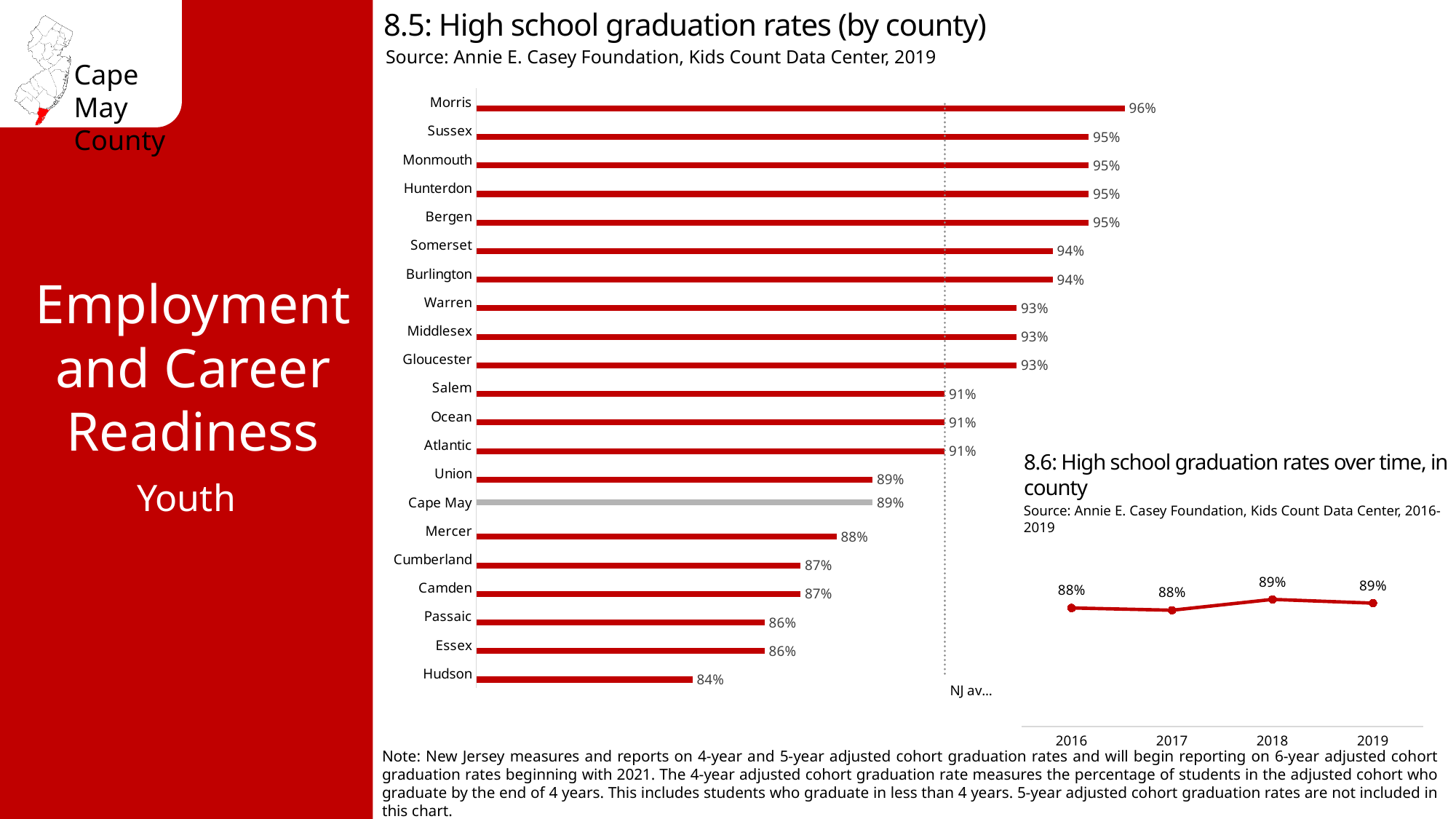
How many counties are shown in the chart '8.5: High school graduation rates (by county)'? 21 In the chart '8.5: High school graduation rates (by county)', which has a higher graduation rate, Somerset or Passaic? Somerset In the chart '8.5: High school graduation rates (by county)', which county has the highest graduation rate? Morris In the chart '8.5: High school graduation rates (by county)', what is the difference between the graduation rates of Morris and Hudson? 12% In the chart '8.6: High school graduation rates over time, in county', how many years are plotted? 4 In the chart '8.6: High school graduation rates over time, in county', what was the graduation rate in 2016? 88% In the chart '8.5: High school graduation rates (by county)', which county has the lowest graduation rate? Hudson In the chart '8.6: High school graduation rates over time, in county', does the graduation rate rise or fall from 2016 to 2019? Rise In the chart '8.5: High school graduation rates (by county)', what is the graduation rate for Mercer? 88% In the chart '8.5: High school graduation rates (by county)', which bar is shown in grey instead of red? Cape May What kind of chart is '8.5: High school graduation rates (by county)'? Bar chart In the chart '8.5: High school graduation rates (by county)', what is the graduation rate for Cape May? 89%